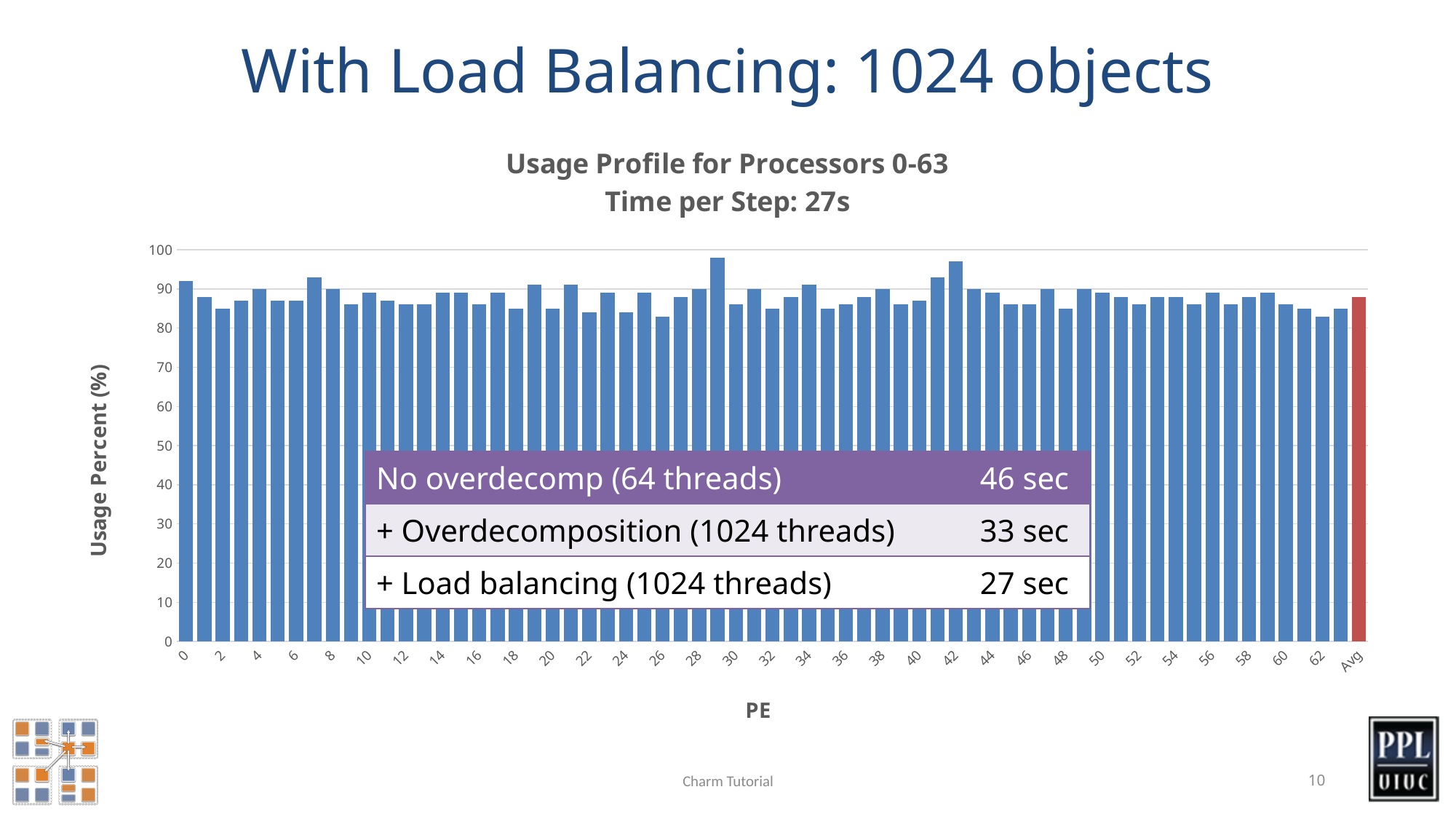
How many bars are plotted in the chart, including the Avg bar? 65 What kind of chart is shown on the slide? bar chart Is the value for Avg greater or less than 80? greater Is the value for PE 29 greater or less than 90? greater Which of PE 29 and PE 26 has the larger usage percent? PE 29 Is the value for PE 0 greater or less than 90? greater What is the label of the y axis of the chart? Usage Percent (%) What is the title of the chart? Usage Profile for Processors 0-63 Time per Step: 27s Do the usage values rise, fall, or stay roughly flat across the PEs along the x axis? roughly flat